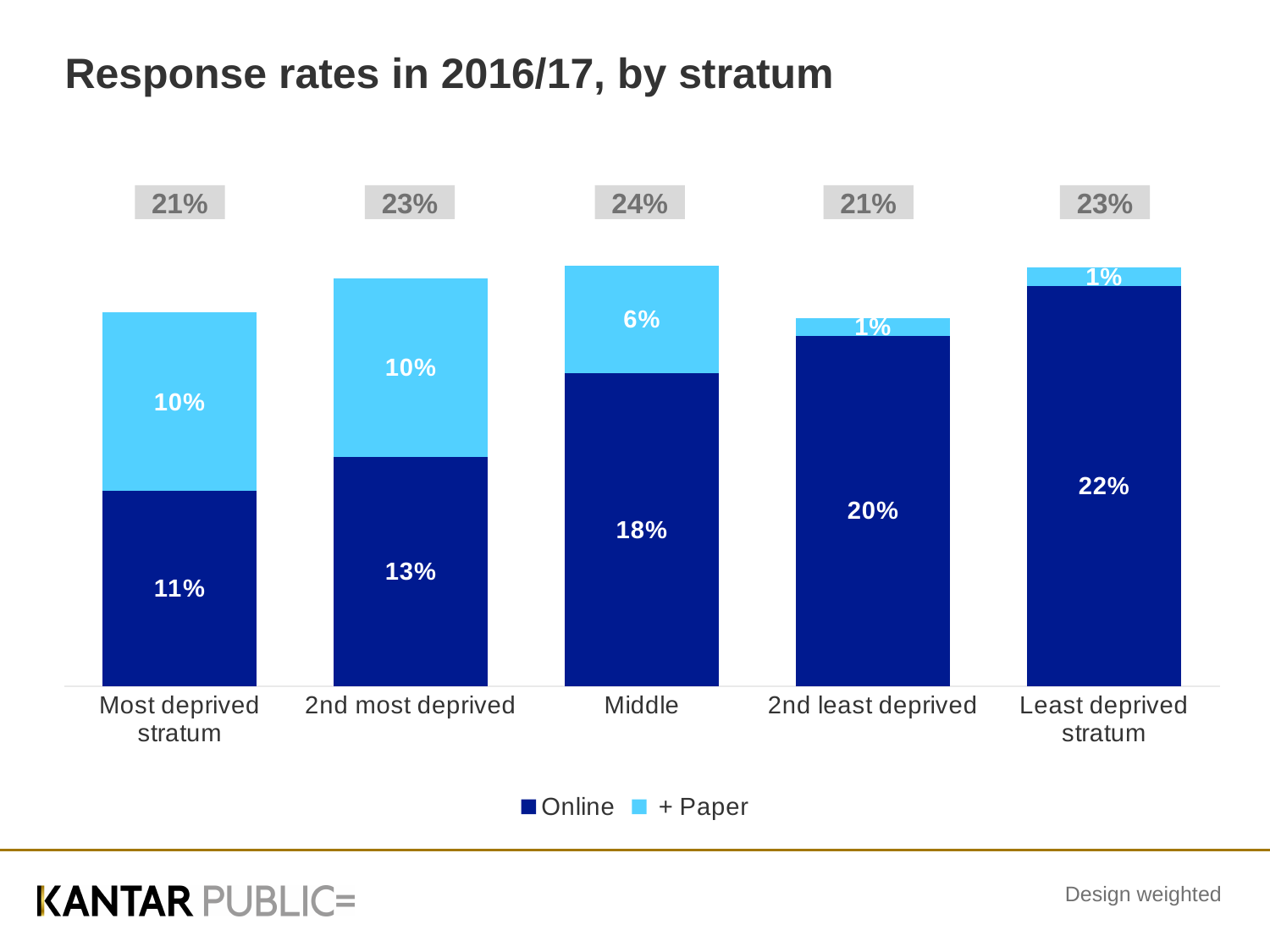
Which stratum has the highest Online response rate? Least deprived stratum What is the difference between the Online response rates of the Least deprived stratum and the Most deprived stratum? 11% What kind of chart is shown on the slide? Stacked bar chart Which stratum has the highest total response rate? Middle How many strata are shown on the x axis? 5 What is the Online response rate for the Least deprived stratum? 22% What is the total response rate for the 2nd most deprived stratum? 23% What is the + Paper response rate for the 2nd most deprived stratum? 10% Which stratum has the lowest Online response rate? Most deprived stratum What is the Online response rate for the Middle stratum? 18% Which is larger, the + Paper response rate for the Middle stratum or for the 2nd least deprived stratum? Middle How many series does the legend list? 2